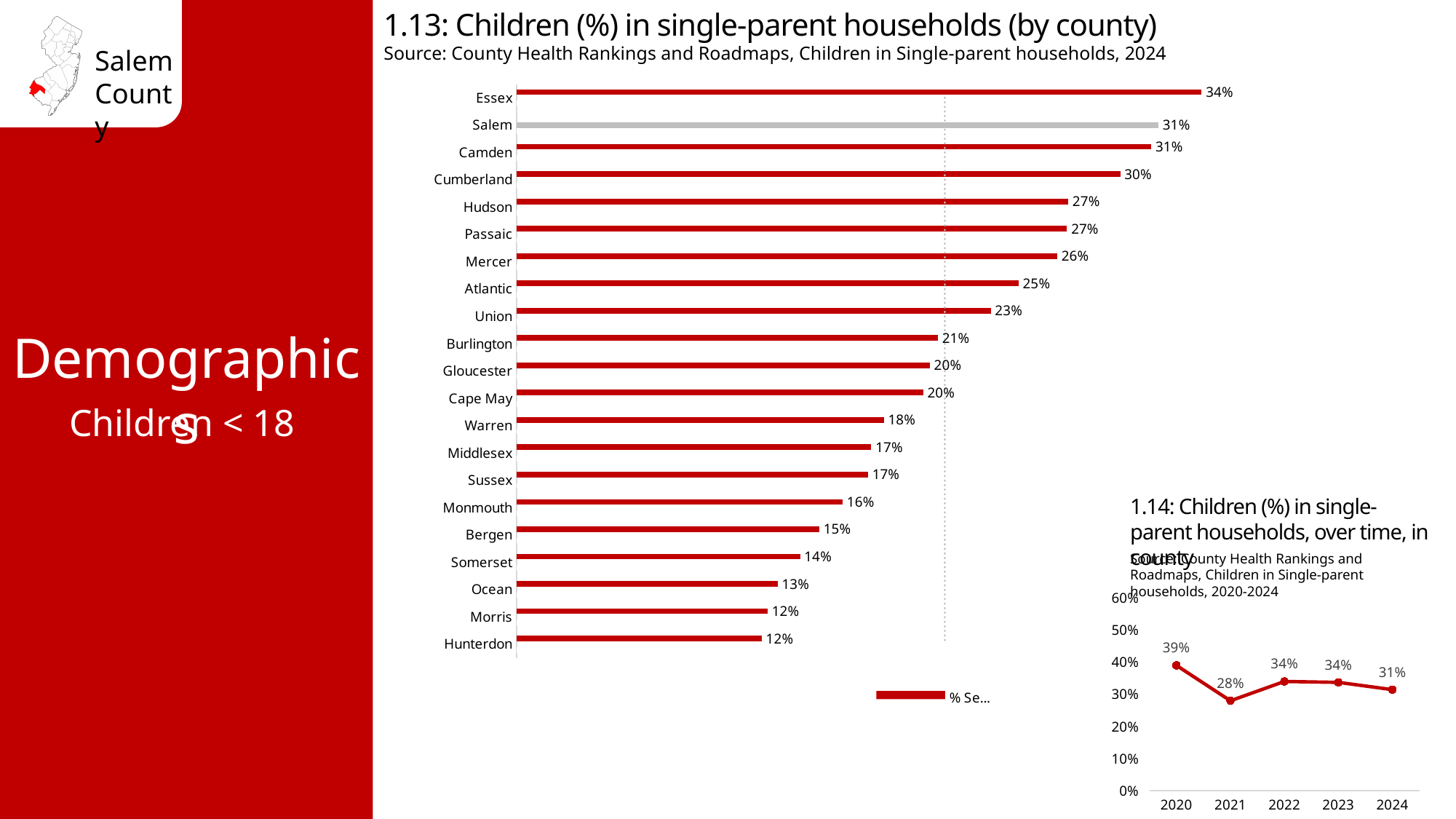
In chart 1.13 (by county), what is the value for Gloucester? 20% In chart 1.14 (Children (%) in single-parent households over time), what is the value for 2020? 39% In chart 1.13 (by county), what is the difference between Essex and Hunterdon? 22% What kind of chart is chart 1.14 (Children (%) in single-parent households over time)? Line chart In chart 1.13 (by county), which county has the highest percentage of children in single-parent households? Essex In chart 1.13 (by county), what is the value for Cumberland? 30% What kind of chart is chart 1.13 (Children (%) in single-parent households by county)? Bar chart In chart 1.14 (over time), which year has the lowest value? 2021 In chart 1.13 (by county), which is larger, the value for Atlantic or the value for Union? Atlantic In chart 1.14 (over time), what is the difference between the 2020 and 2024 values? 8% In chart 1.13 (by county), how many counties are shown? 21 In chart 1.13 (Children (%) in single-parent households by county), what is the value for Salem? 31%